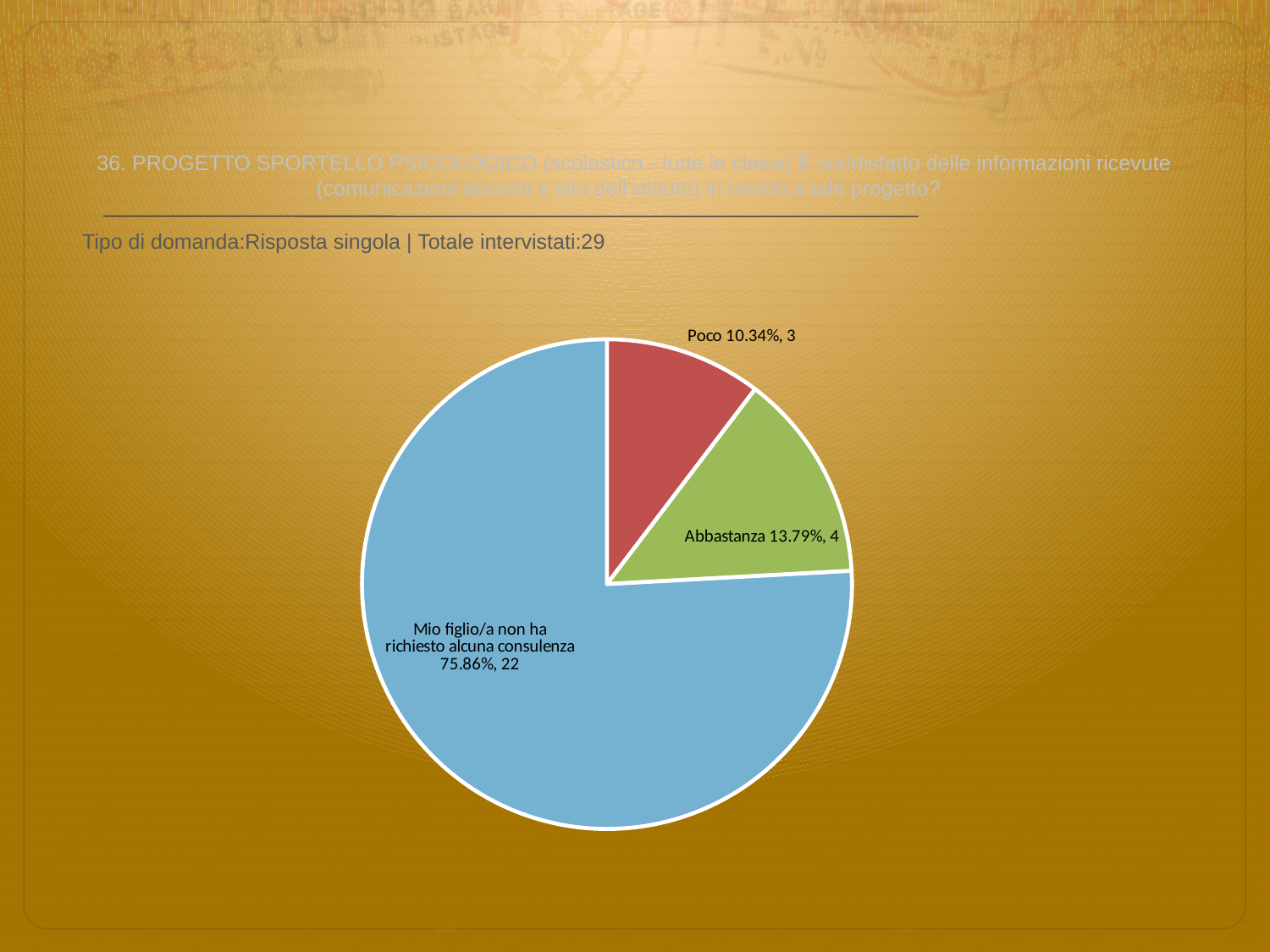
How many respondents chose "Poco"? 3 What percentage share does the "Poco" slice have? 10.34% Which category has the largest slice of the pie? Mio figlio/a non ha richiesto alcuna consulenza What percentage share does the "Abbastanza" slice have? 13.79% What is the difference in respondent count between "Mio figlio/a non ha richiesto alcuna consulenza" and "Abbastanza"? 18 Which slice is larger, "Abbastanza" or "Poco"? Abbastanza What percentage share does the "Mio figlio/a non ha richiesto alcuna consulenza" slice have? 75.86% What kind of chart is shown on the slide? pie chart Which category has the smallest slice of the pie? Poco How many slices does the pie chart have? 3 How many respondents chose "Mio figlio/a non ha richiesto alcuna consulenza"? 22 How many respondents chose "Abbastanza"? 4